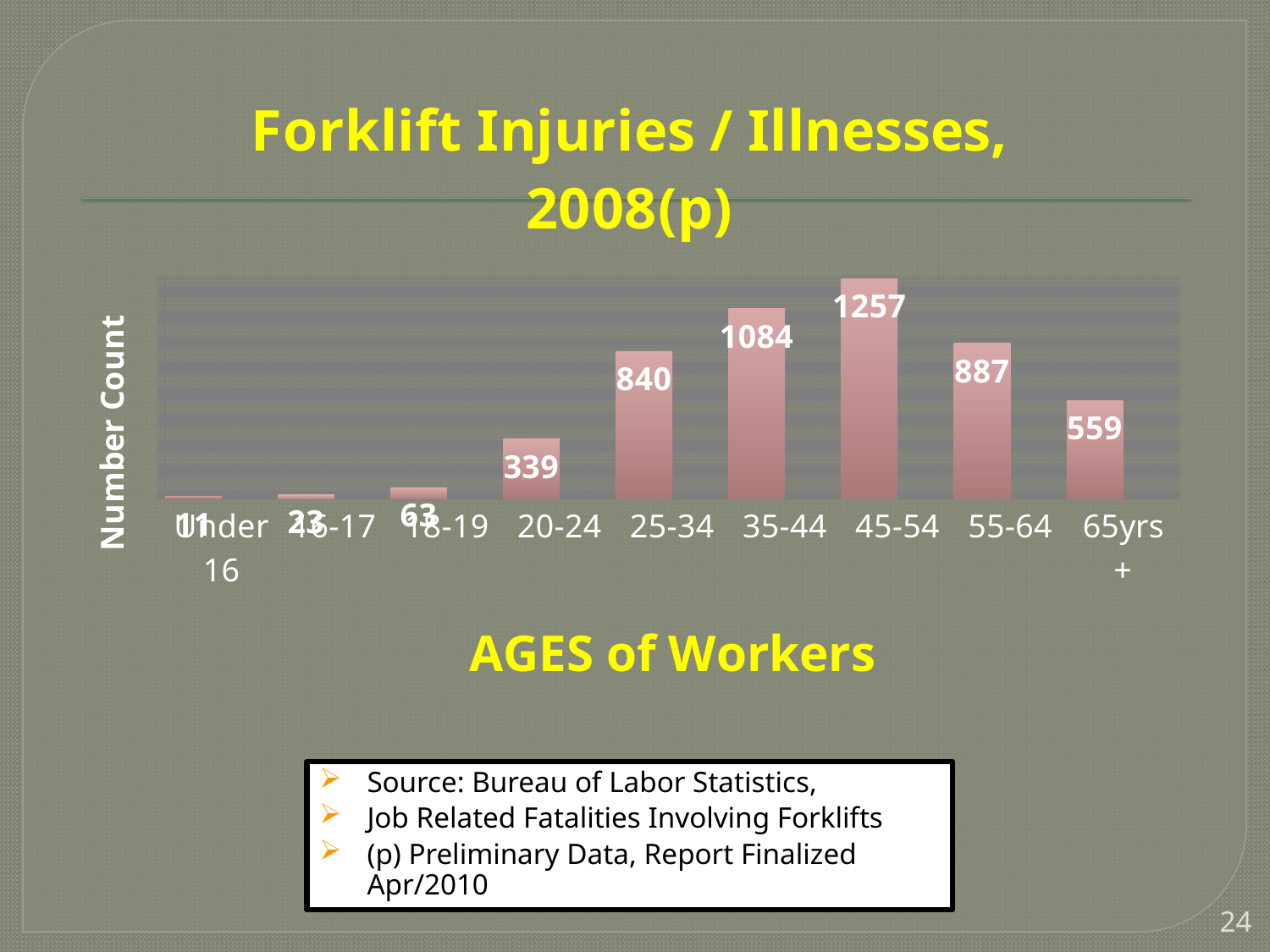
What is the number count for the 20-24 age group? 339 Which age group has the lowest number count? Under 16 What is the number count for workers aged 65yrs +? 559 What is the number count for the 25-34 age group? 840 What is the difference between the counts for the 55-64 and 65yrs + groups? 328 How many age groups are shown on the chart? 9 How much higher is the count for the 45-54 group than for the 35-44 group? 173 Do the values rise or fall from the 20-24 group to the 45-54 group? Rise Which has a larger number count, the 25-34 group or the 55-64 group? 55-64 What type of chart is used on this slide? Bar chart What is the number count for the 45-54 age group? 1257 Which age group has the highest number count? 45-54